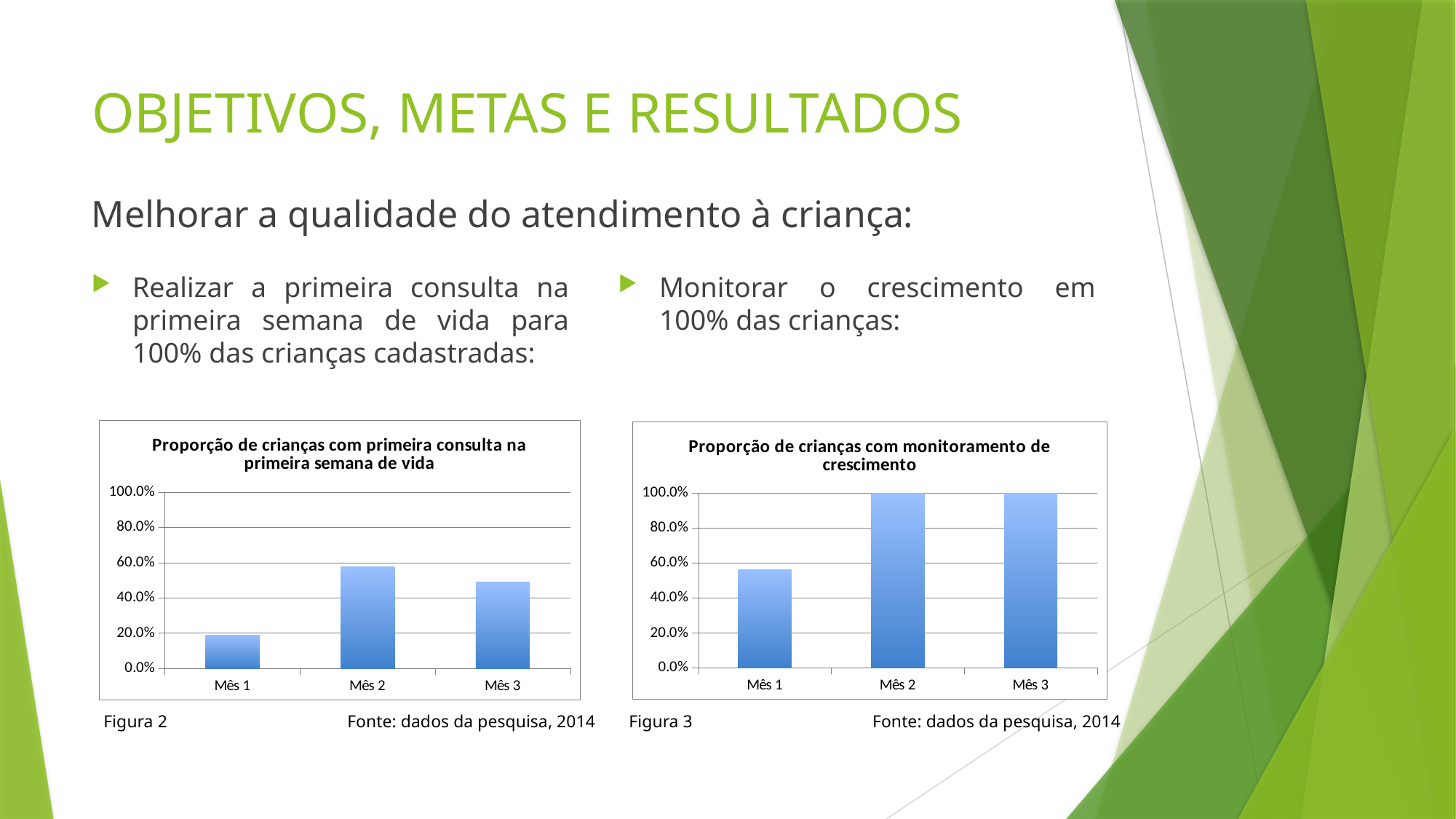
In the left chart, 'Proporção de crianças com primeira consulta na primeira semana de vida', how many categories are shown on the x axis? 3 What is the source cited below both charts? Fonte: dados da pesquisa, 2014 In the right chart, 'Proporção de crianças com monitoramento de crescimento', what is the value for Mês 2? 100.0% In the left chart, 'Proporção de crianças com primeira consulta na primeira semana de vida', which month has the lowest value? Mês 1 In the left chart, 'Proporção de crianças com primeira consulta na primeira semana de vida', which is larger, the value for Mês 2 or Mês 3? Mês 2 In the right chart, 'Proporção de crianças com monitoramento de crescimento', which month has the lowest value? Mês 1 In the left chart, 'Proporção de crianças com primeira consulta na primeira semana de vida', is the value for Mês 3 greater or less than 40.0%? greater What kind of chart is the left chart, 'Proporção de crianças com primeira consulta na primeira semana de vida'? Bar chart In the left chart, 'Proporção de crianças com primeira consulta na primeira semana de vida', which month has the highest value? Mês 2 In the right chart, 'Proporção de crianças com monitoramento de crescimento', is the value for Mês 1 greater or less than 60.0%? less In the right chart, 'Proporção de crianças com monitoramento de crescimento', what is the value for Mês 3? 100.0%